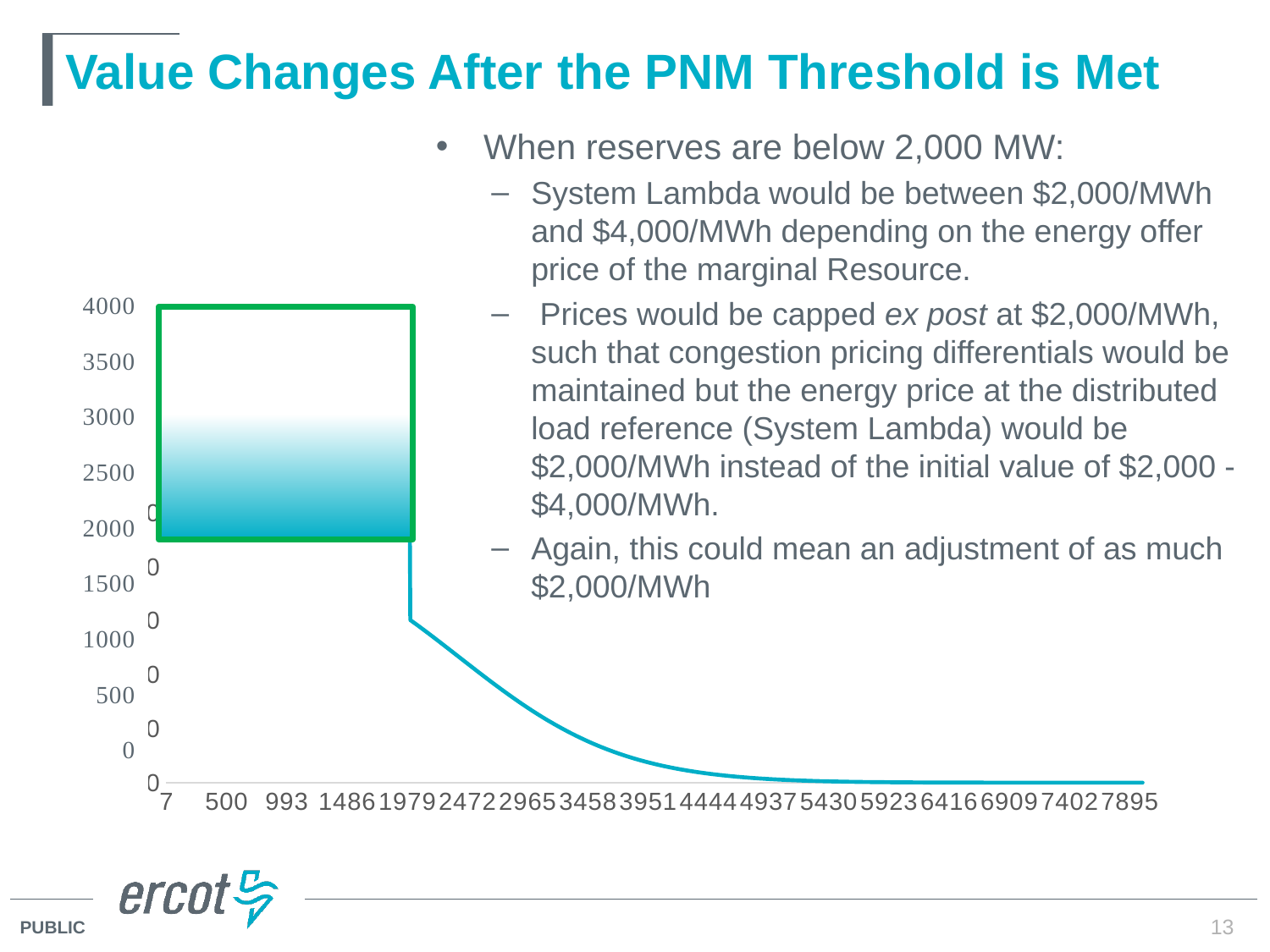
Is the plotted value at x = 7895 greater or less than 500? less Do the plotted values rise or fall as you move from left to right along the x axis? fall Is the plotted value at x = 2965 greater or less than 1000? less What is the first label shown on the x axis of the chart? 7 How many labels are shown along the x axis of the chart? 17 What kind of chart is shown on the slide? line chart Is the plotted value at x = 4937 greater or less than 500? less What is the highest tick value shown on the y axis of the chart? 4000